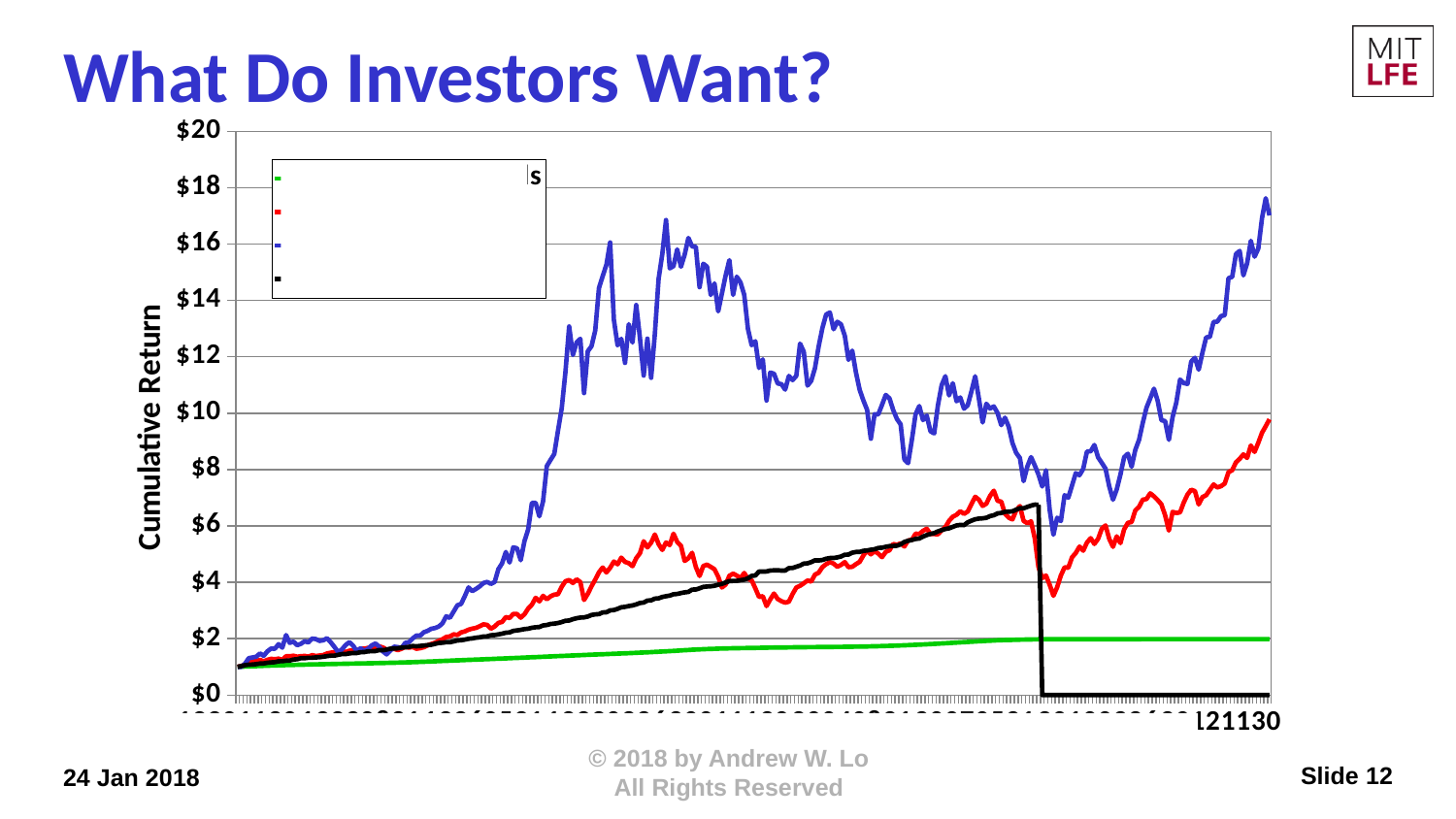
Is the value of the red line at the right-hand end of the chart greater or less than $8? greater Is the peak value of the black line greater or less than $8? less Is the peak value of the blue line greater or less than $16? greater What is the highest value shown on the vertical axis? $20 Does the green line generally rise or fall from left to right? rise What is the title of the vertical axis? Cumulative Return What value does the black line end at on the right-hand side of the chart? $0 Which coloured line reaches the highest cumulative return on the chart? blue What kind of chart is shown on the slide? line chart How many series does the legend list? 4 Which coloured line has the lowest value at the right-hand end of the chart? black